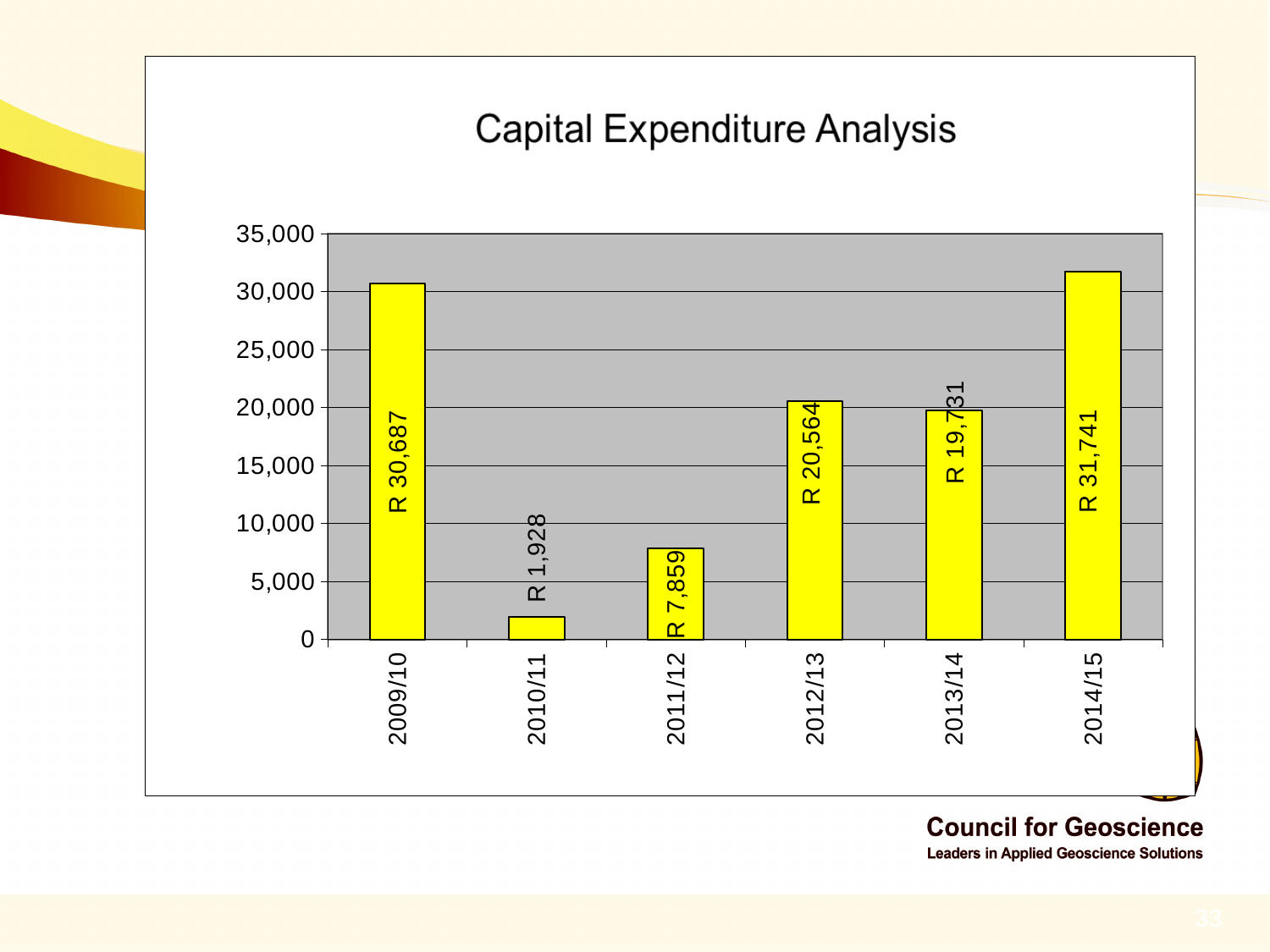
Is the value for 2011/12 greater or less than 10,000? less What is the title of the chart? Capital Expenditure Analysis What is the capital expenditure value for 2010/11? R 1,928 What is the capital expenditure value for 2009/10? R 30,687 How many years are shown on the x axis of the chart? 6 What is the capital expenditure value for 2012/13? R 20,564 Which year has the lowest capital expenditure? 2010/11 What kind of chart is shown on the slide? Bar chart Which is larger, the capital expenditure for 2012/13 or 2013/14? 2012/13 What is the capital expenditure value for 2014/15? R 31,741 What is the difference between the capital expenditure for 2014/15 and 2009/10? R 1,054 Which year has the highest capital expenditure? 2014/15